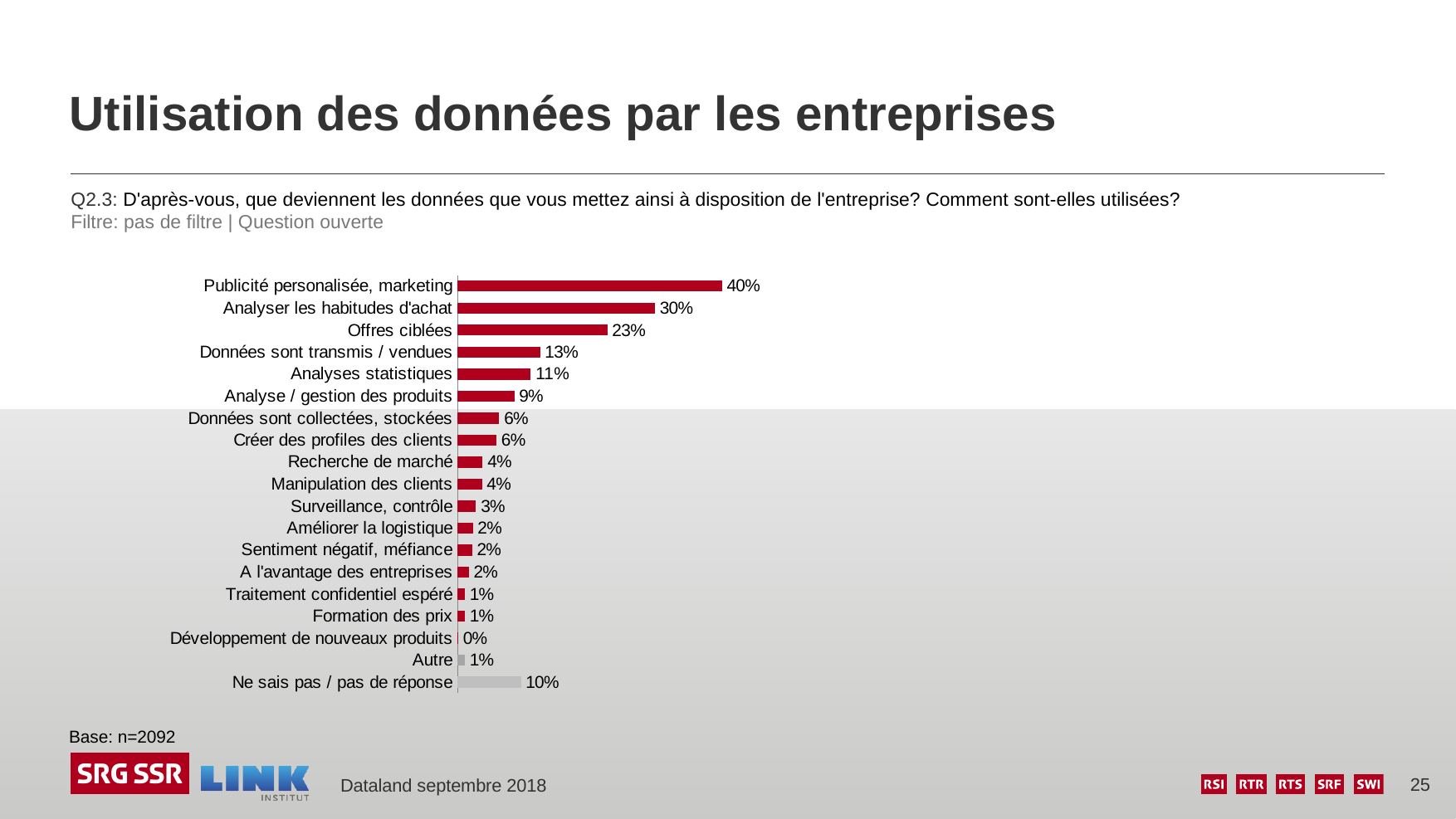
What is the difference between "Publicité personalisée, marketing" and "Offres ciblées"? 17% Which is larger, "Analyses statistiques" or "Analyse / gestion des produits"? Analyses statistiques What is the value for "Ne sais pas / pas de réponse"? 10% What is the value for "Données sont transmis / vendues"? 13% What is the base (n) stated below the chart? n=2092 What is the value for "Analyser les habitudes d'achat"? 30% What is the value for "Surveillance, contrôle"? 3% Which category has the highest value? Publicité personalisée, marketing What kind of chart is shown on the slide? Bar chart What is the value for "Publicité personalisée, marketing"? 40% Which category has the lowest value? Développement de nouveaux produits How many categories are shown in the chart? 19